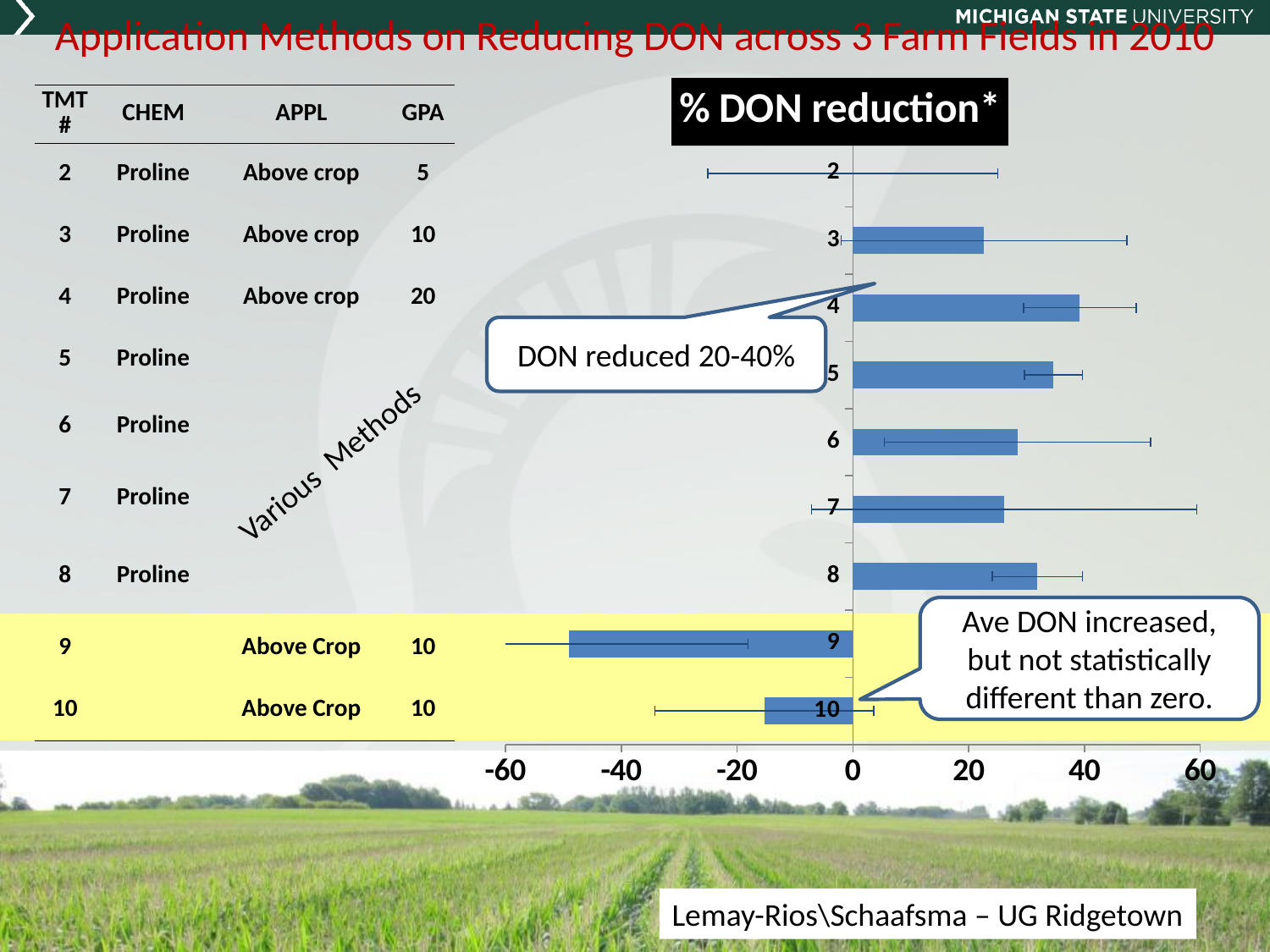
Which has the larger % DON reduction, treatment 9 or treatment 10? 10 How many treatment categories are plotted in the chart? 9 What kind of chart is shown on the slide? Bar chart Which has the larger % DON reduction, treatment 3 or treatment 4? 4 How many treatments show a negative % DON reduction? 2 What are the minimum and maximum values shown on the horizontal axis? -60 and 60 Is the value for treatment 10 greater or less than 0? less Is the value for treatment 9 greater or less than -40? less Which treatment has the lowest % DON reduction? 9 What is the title of the chart? % DON reduction* Is the value for treatment 8 greater or less than 20? greater